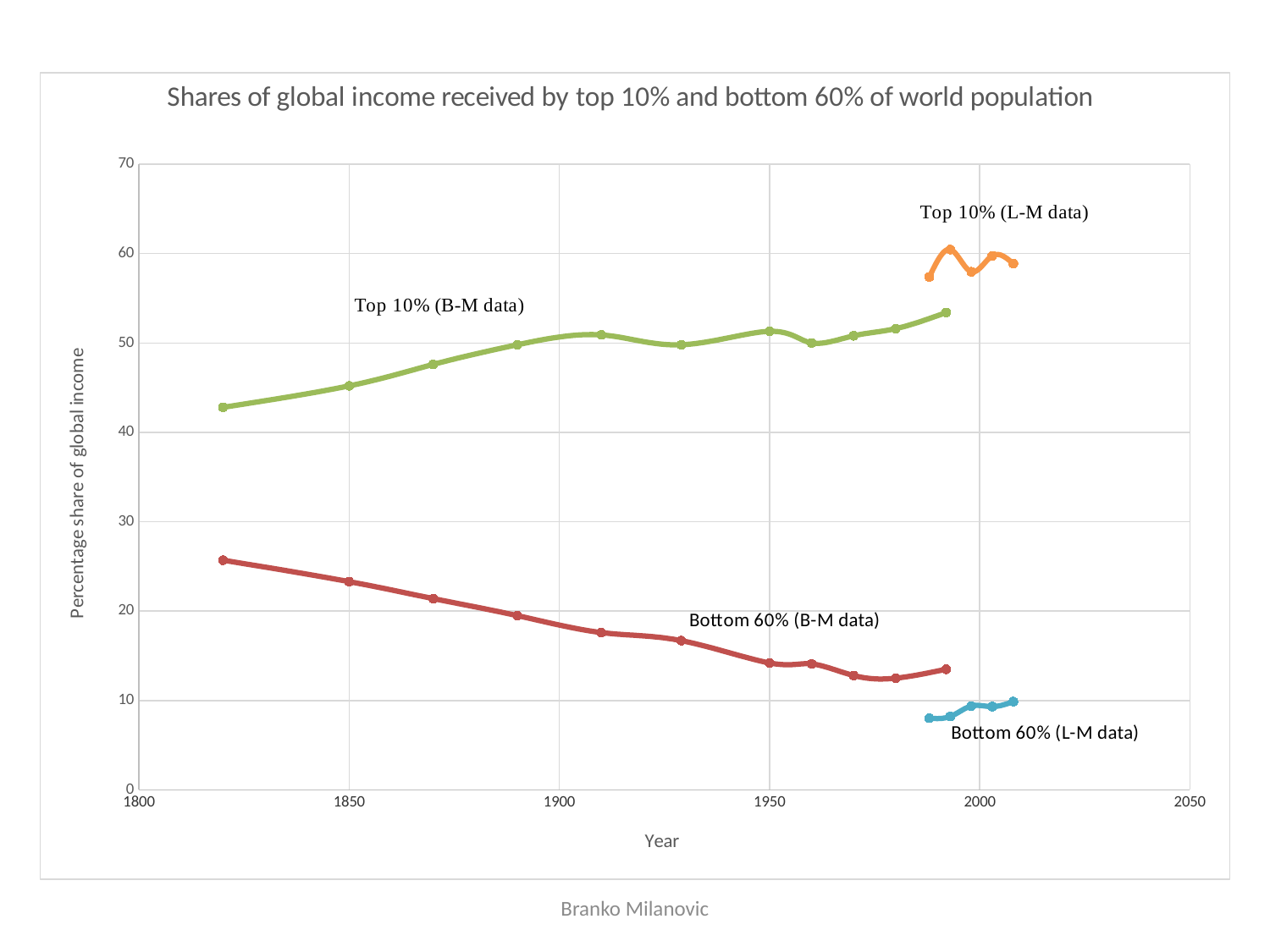
Is the value for Top 10% (B-M data) in 1820 greater or less than 50? less What is the title of the chart? Shares of global income received by top 10% and bottom 60% of world population Is the first value of Bottom 60% (L-M data) greater or less than 10? less What is the label of the vertical axis? Percentage share of global income Is the value for Bottom 60% (B-M data) in 1820 greater or less than 20? greater What kind of chart is shown on the slide? Line chart How many data series (lines) are plotted on the chart? 4 Does the Top 10% (B-M data) line generally rise or fall from 1820 to the 1990s? Rise Does the Bottom 60% (B-M data) line generally rise or fall from 1820 to the 1980s? Fall Which series reaches the highest values on the chart? Top 10% (L-M data) Which series has the lowest values on the chart? Bottom 60% (L-M data)